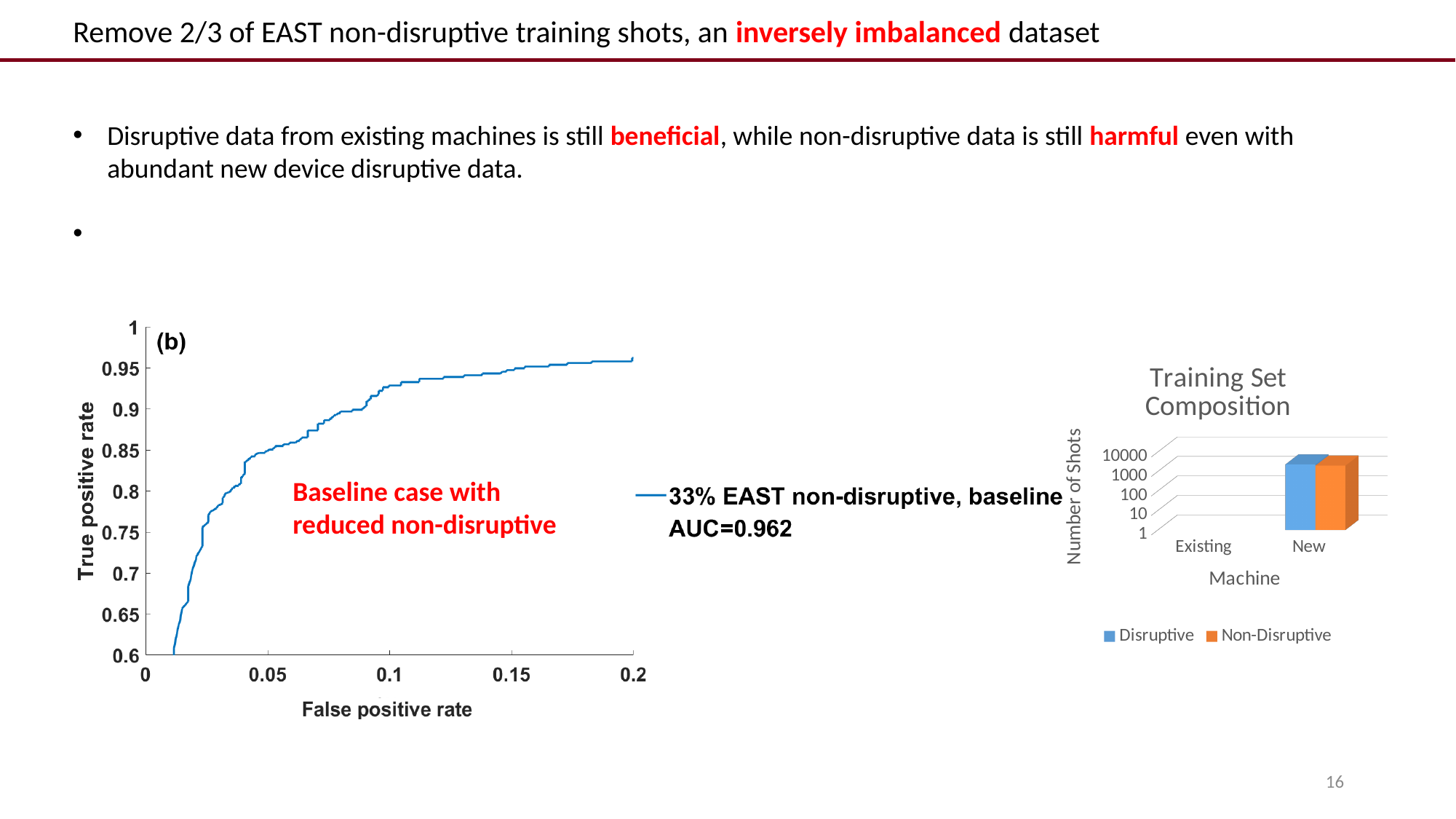
In the left chart, at a false positive rate of 0.1, is the true positive rate greater or less than 0.9? greater In the left chart, at a false positive rate of 0.05, is the true positive rate greater or less than 0.8? greater In the left chart, does the true positive rate rise or fall as the false positive rate increases? rises In the left chart, what AUC value is given in the legend? AUC=0.962 What kind of chart is the 'Training Set Composition' chart? bar chart What is the title of the chart on the right of the slide? Training Set Composition In the 'Training Set Composition' chart, which machine category has the larger number of shots, Existing or New? New In the 'Training Set Composition' chart, how many series does the legend list? 2 In the 'Training Set Composition' chart, is the number of Disruptive shots for New greater or less than 1000? greater In the 'Training Set Composition' chart, how many machine categories are shown on the x axis? 2 What kind of chart is the chart on the left of the slide? line chart